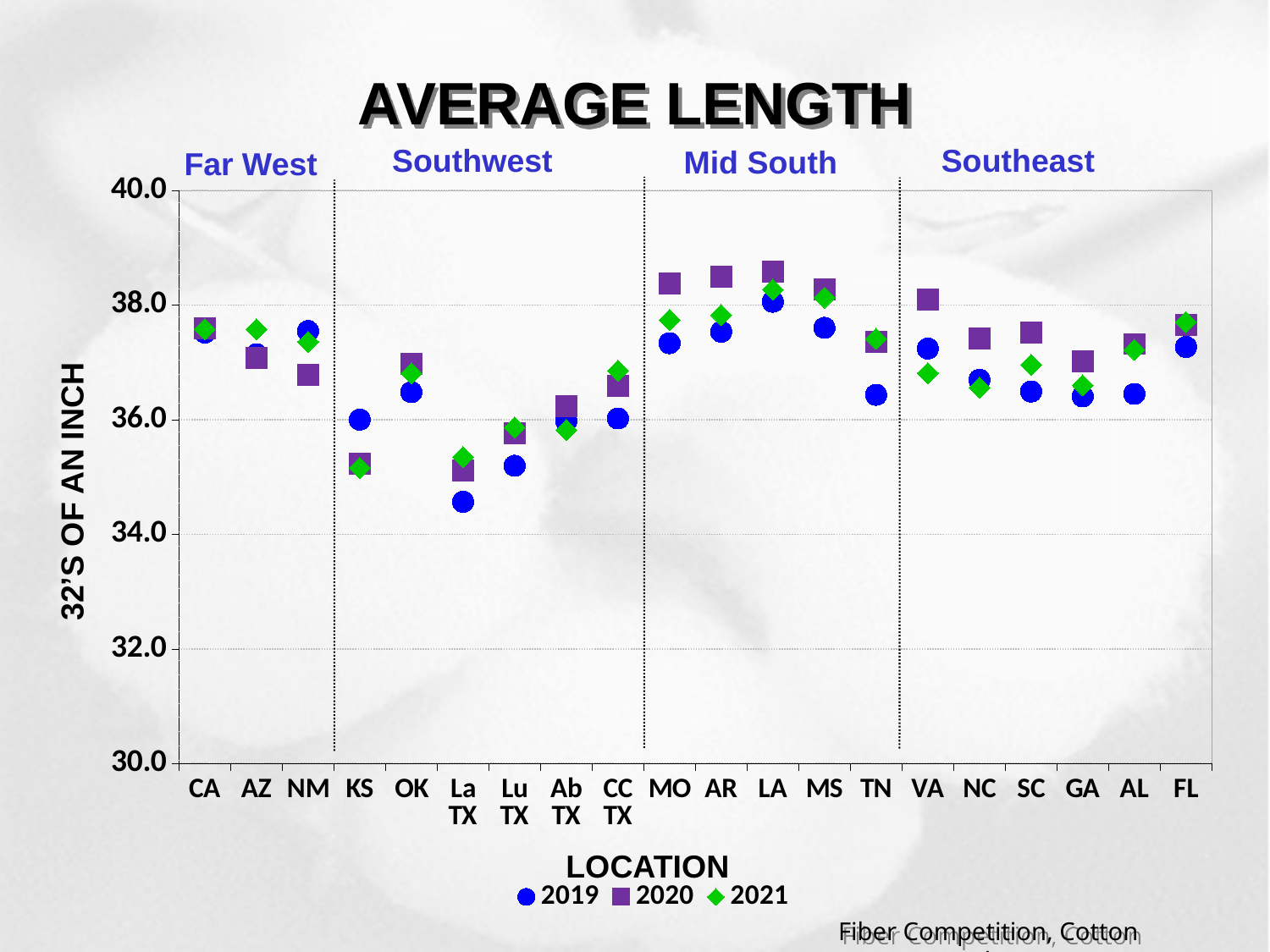
For MO, which is larger: the 2019 value or the 2020 value? 2020 Is the 2019 value for La TX greater or less than 36.0? less Is the 2019 value for MO greater or less than 38.0? less What is the label on the y axis? 32'S OF AN INCH How many series does the legend list? 3 Is the 2021 value for KS greater or less than 36.0? less What kind of chart is shown on the slide? scatter chart What is the title of the chart? AVERAGE LENGTH Which location has the highest 2019 value? LA Which location has the lowest 2019 value? La TX How many locations are plotted along the x axis? 20